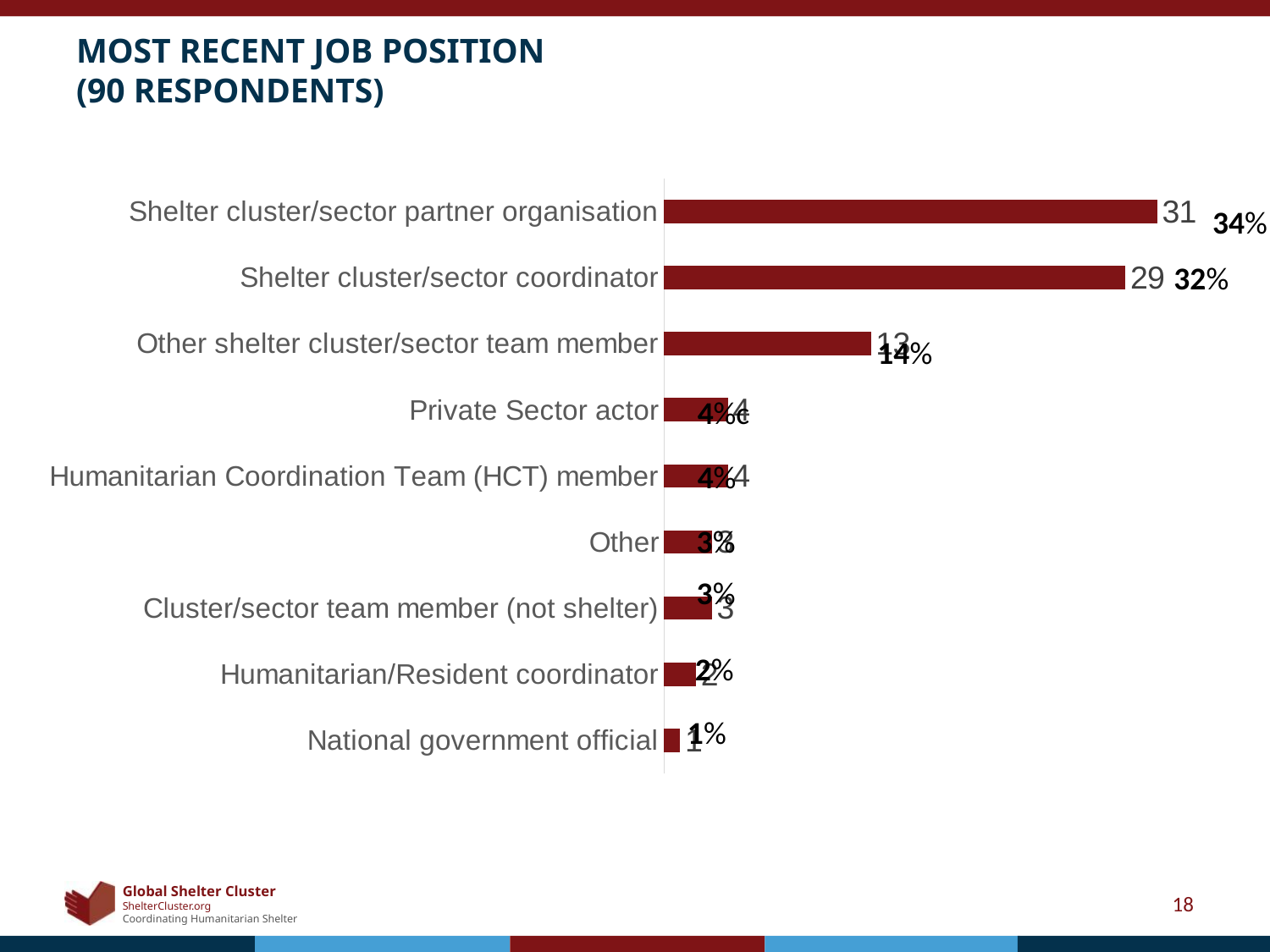
What is the title of the chart? MOST RECENT JOB POSITION (90 RESPONDENTS) Which has more respondents: Shelter cluster/sector coordinator or Other shelter cluster/sector team member? Shelter cluster/sector coordinator How many respondents were Other shelter cluster/sector team members? 13 What is the difference in the number of respondents between Shelter cluster/sector partner organisation and Shelter cluster/sector coordinator? 2 Which job position has the highest number of respondents? Shelter cluster/sector partner organisation How many job position categories are shown in the chart? 9 What kind of chart is shown on the slide? Bar chart What percentage of respondents were National government officials? 1% Which job position has the lowest number of respondents? National government official What percentage of respondents were Shelter cluster/sector coordinators? 32% How many respondents reported Shelter cluster/sector partner organisation as their most recent job position? 31 What percentage of respondents were Humanitarian/Resident coordinators? 2%